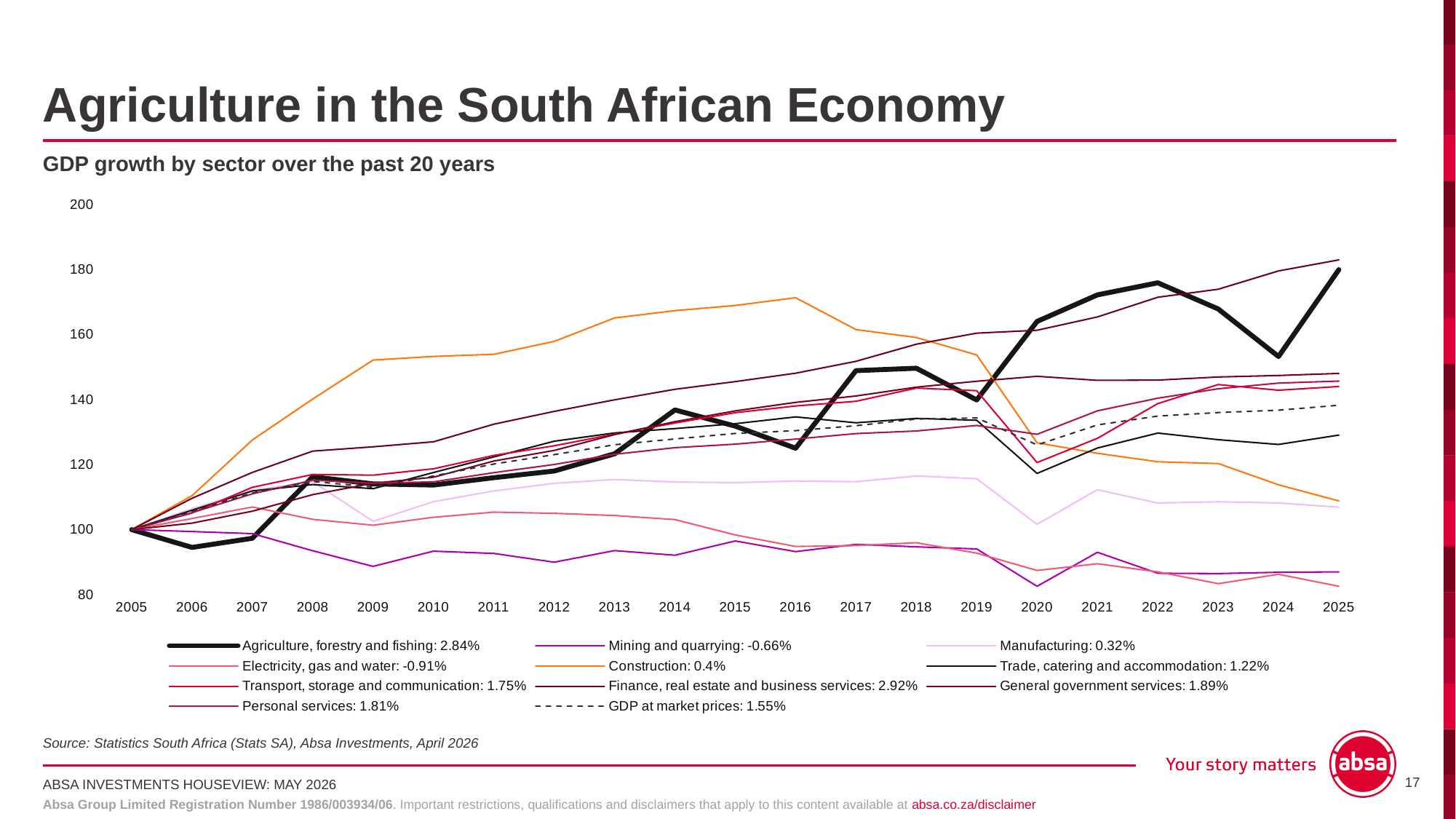
What type of chart is shown on the slide? Line chart Is the value for Agriculture, forestry and fishing in 2025 greater or less than 160? greater Does the Mining and quarrying line rise or fall overall from 2005 to 2025? Fall In 2016, which is higher: Construction or Agriculture, forestry and fishing? Construction Which series is drawn with a dashed line? GDP at market prices: 1.55% Which sector has the lowest growth rate listed in the legend? Electricity, gas and water: -0.91% How many years are shown along the x axis? 21 What growth rate does the legend give for GDP at market prices? 1.55% Is the value for Mining and quarrying in 2020 greater or less than 100? less Which sector has the highest growth rate listed in the legend? Finance, real estate and business services: 2.92% What growth rate does the legend give for Agriculture, forestry and fishing? 2.84% How many series does the legend list? 11